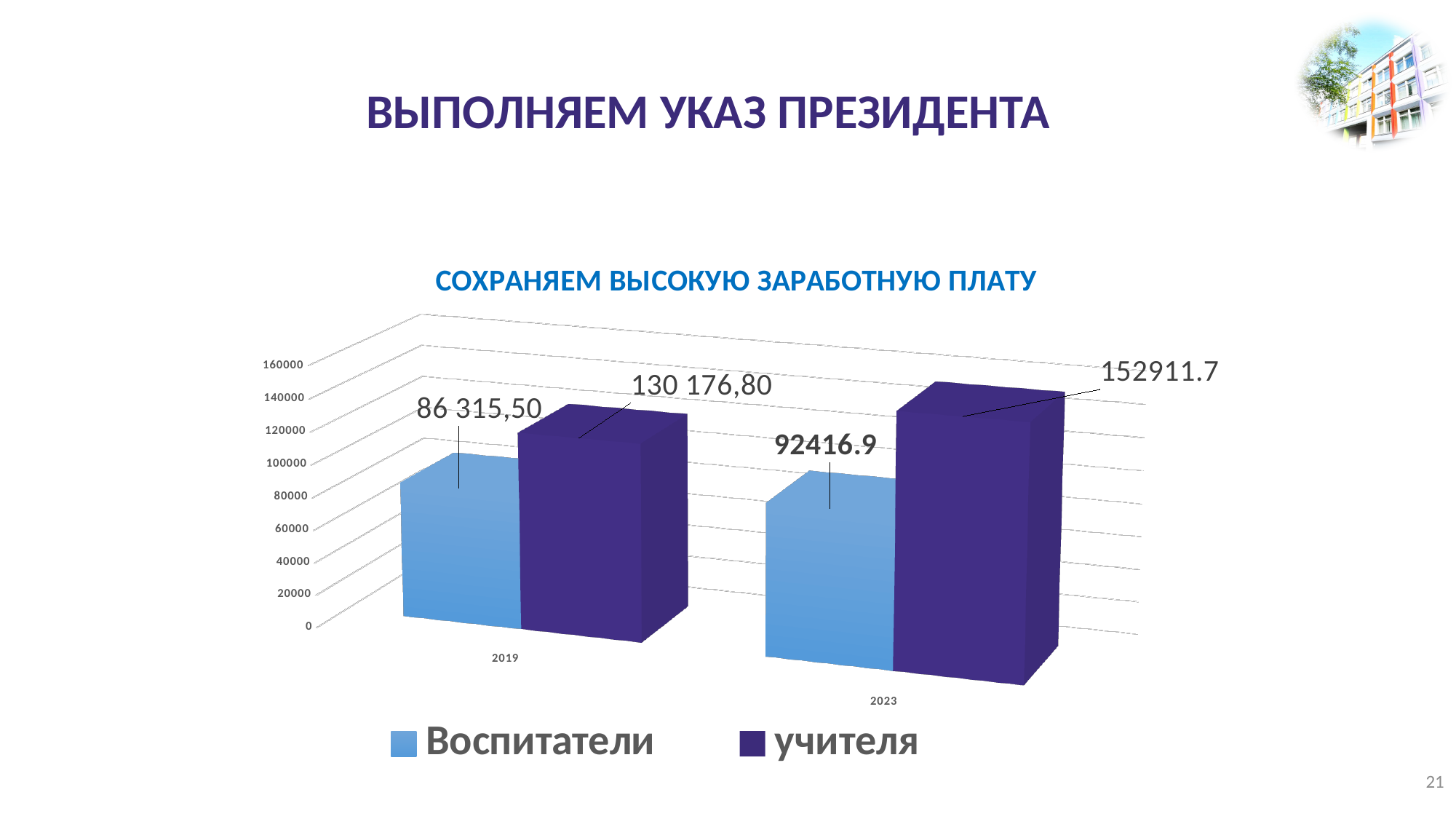
Which bar has the lowest value on the chart? Воспитатели in 2019 What is the value for учителя in 2019? 130 176,80 Do the values for учителя rise or fall from 2019 to 2023? Rise Which series has the highest value in 2023? учителя What is the value for Воспитатели in 2023? 92416.9 What is the value for Воспитатели in 2019? 86 315,50 How many series does the legend list? 2 What is the value for учителя in 2023? 152911.7 What kind of chart is shown on the slide? Bar chart What is the difference between учителя and Воспитатели in 2023? 60494.8 How many categories are shown on the x axis? 2 Which is larger: the value for Воспитатели in 2019 or in 2023? 2023